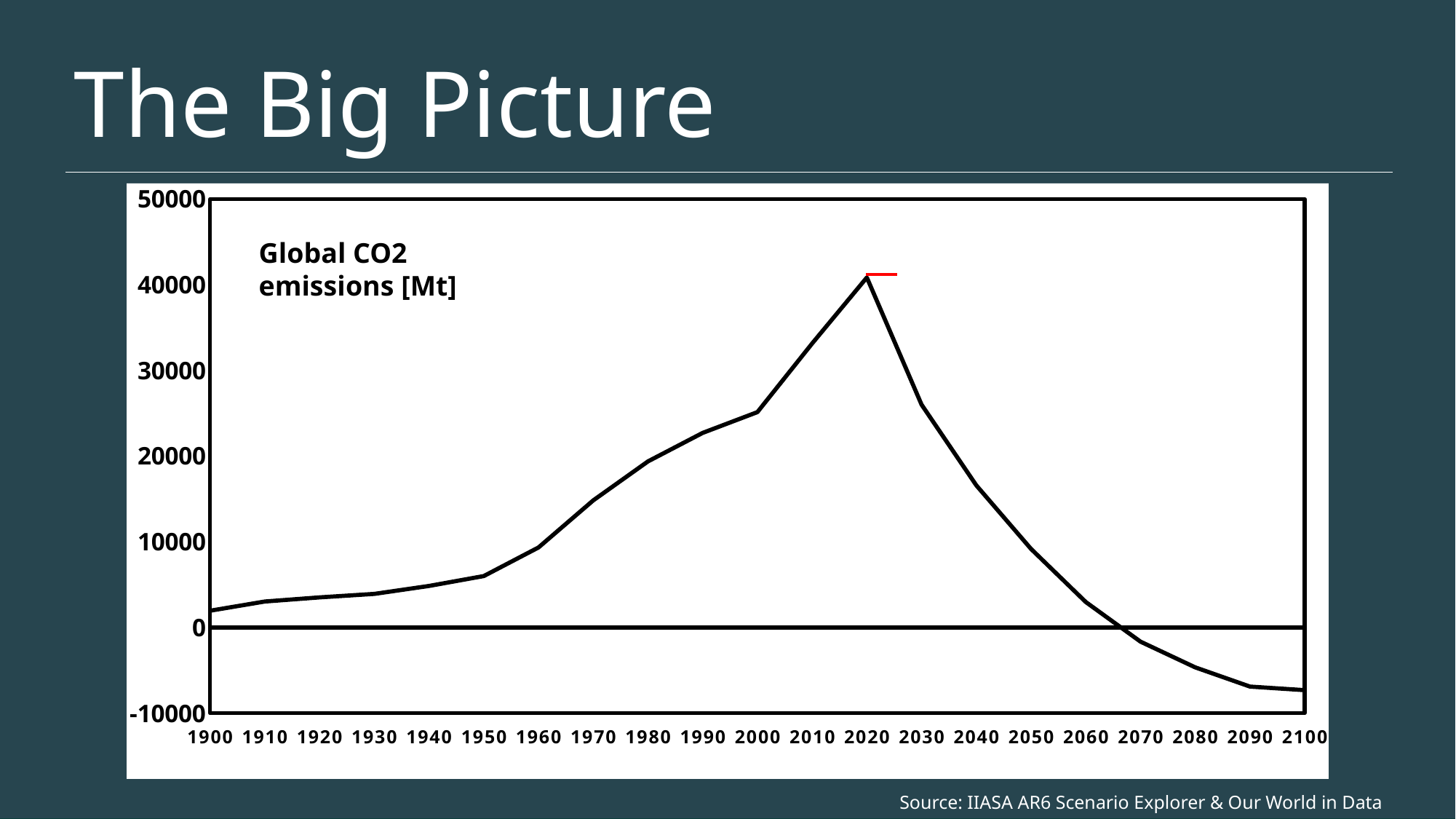
Is the value for 1950 greater or less than 10000? less Do the values rise or fall along the x axis from 1900 to 2020? rise Is the value for 2040 greater or less than 10000? greater Is the value for 2000 greater or less than 20000? greater How many years are labelled along the x axis of the chart? 21 What kind of chart is shown on the slide? line chart In which year does the line reach its highest value? 2020 What is the title of the chart? Global CO2 emissions [Mt] Do the values rise or fall along the x axis from 2020 to 2100? fall Which year has the larger value, 2010 or 2030? 2010